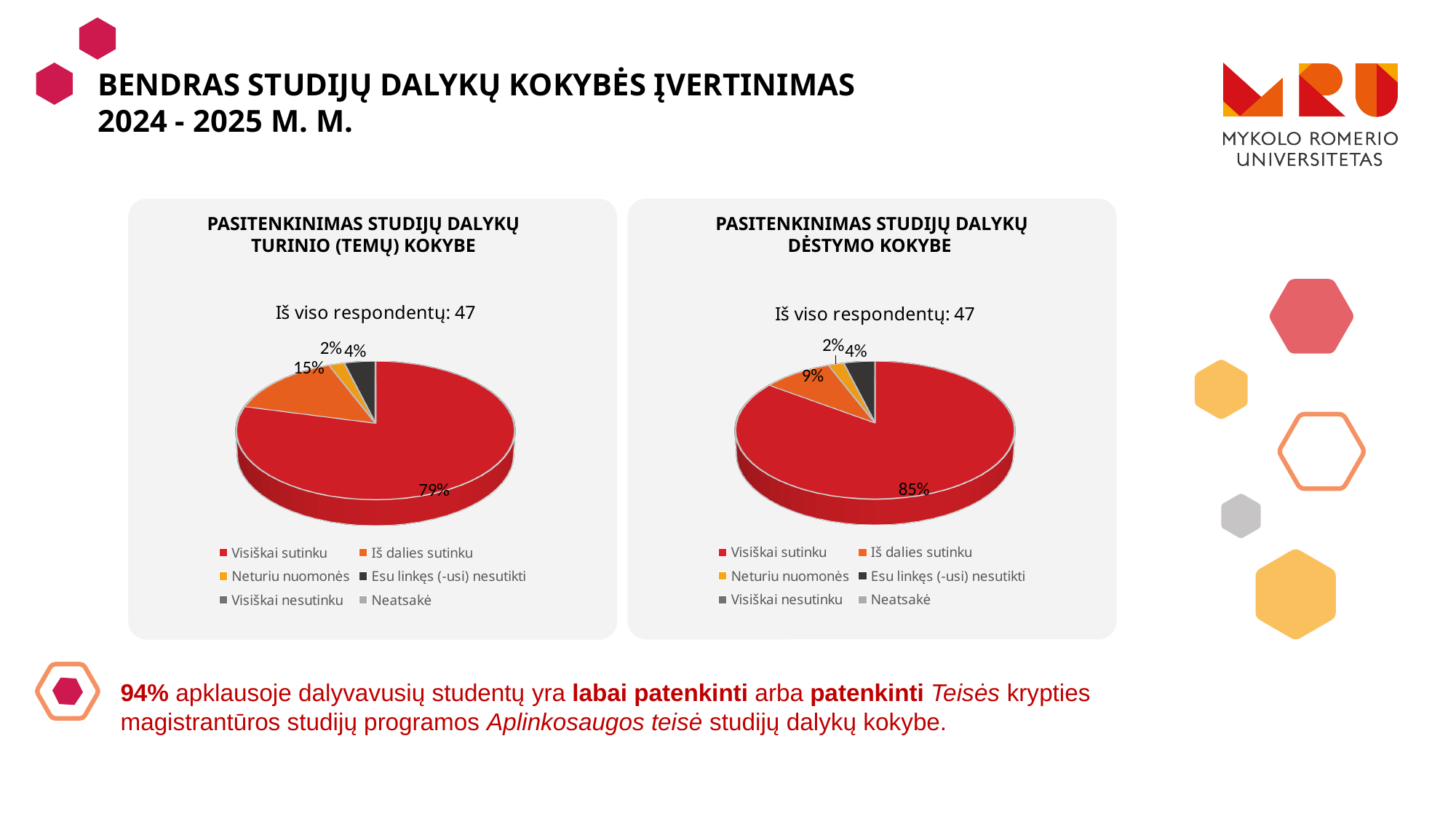
What is the difference between the 'Visiškai sutinku' share in the right chart (85%) and in the left chart (79%)? 6 percentage points In the right chart, 'Pasitenkinimas studijų dalykų dėstymo kokybe', which category has the largest slice? Visiškai sutinku What kind of chart is used in the left chart, 'Pasitenkinimas studijų dalykų turinio (temų) kokybe'? Pie chart In the left chart, 'Pasitenkinimas studijų dalykų turinio (temų) kokybe', what share is labelled for 'Iš dalies sutinku'? 15% Which chart has the larger 'Iš dalies sutinku' slice, the left chart or the right chart? The left chart How many respondents are reported for the right chart, 'Pasitenkinimas studijų dalykų dėstymo kokybe'? 47 In the right chart, 'Pasitenkinimas studijų dalykų dėstymo kokybe', what share is labelled for 'Iš dalies sutinku'? 9% In the left chart, 'Pasitenkinimas studijų dalykų turinio (temų) kokybe', what share is labelled for 'Visiškai sutinku'? 79% In the left chart, 'Pasitenkinimas studijų dalykų turinio (temų) kokybe', which labelled category has the smallest slice? Neturiu nuomonės How many entries does the legend of the left chart, 'Pasitenkinimas studijų dalykų turinio (temų) kokybe', list? 6 In the right chart, 'Pasitenkinimas studijų dalykų dėstymo kokybe', what colour is the 'Visiškai sutinku' slice? Red In the right chart, 'Pasitenkinimas studijų dalykų dėstymo kokybe', what share is labelled for 'Visiškai sutinku'? 85%